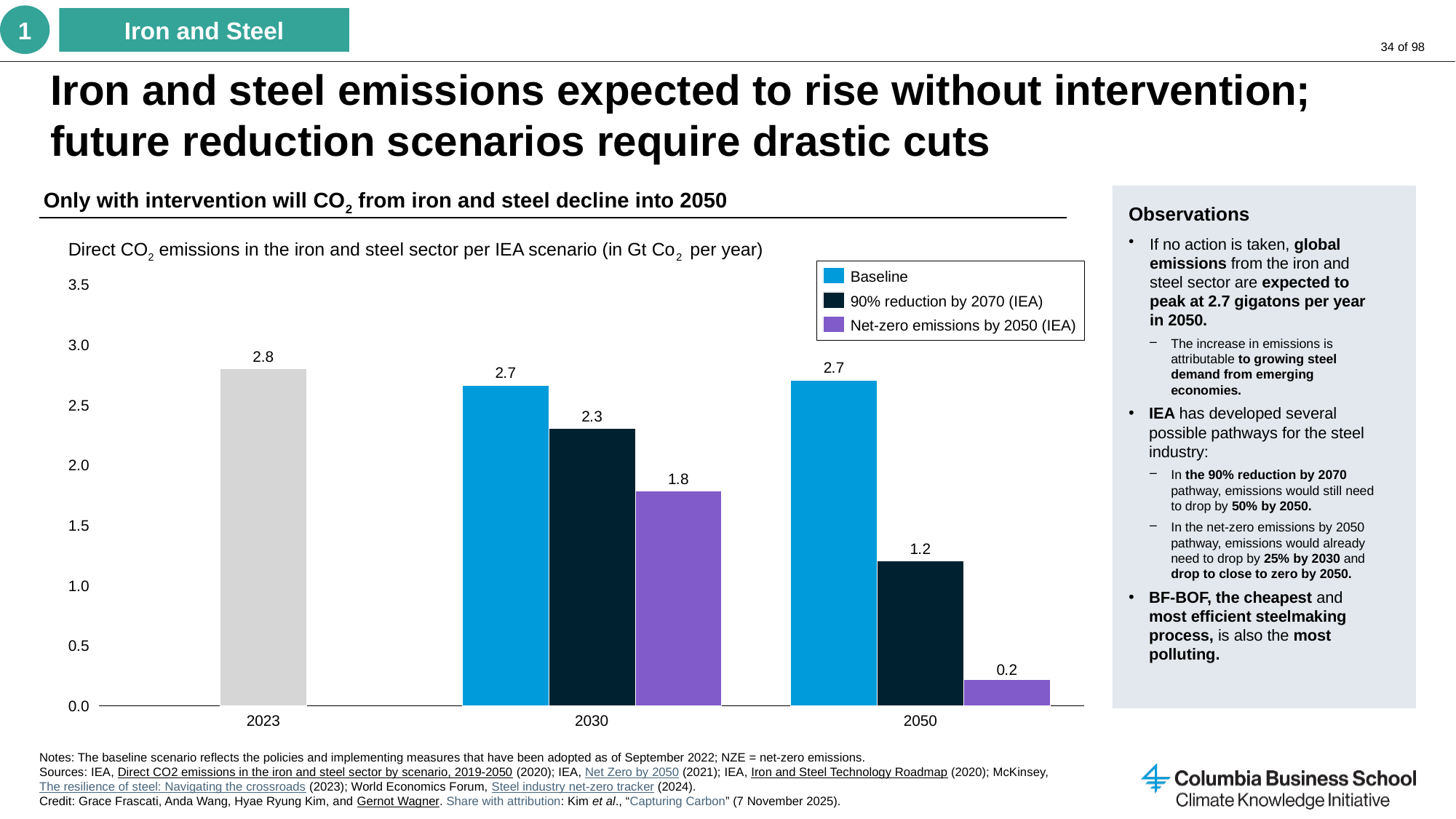
Does the 90% reduction by 2070 (IEA) series rise or fall from 2030 to 2050? fall Which scenario has the lowest value in 2050? Net-zero emissions by 2050 (IEA) How many year categories are shown on the x axis? 3 What is the value for the Net-zero emissions by 2050 (IEA) scenario in 2050? 0.2 What type of chart is shown on the slide? bar chart What is the difference between the Baseline and the 90% reduction by 2070 (IEA) values in 2050? 1.5 Which scenario has the highest value in 2030? Baseline What is the value shown for 2023? 2.8 How many series does the legend list? 3 What is the value for the 90% reduction by 2070 (IEA) scenario in 2030? 2.3 Which is larger: the Net-zero emissions by 2050 (IEA) value in 2030 or in 2050? 2030 What is the Baseline value for 2030? 2.7